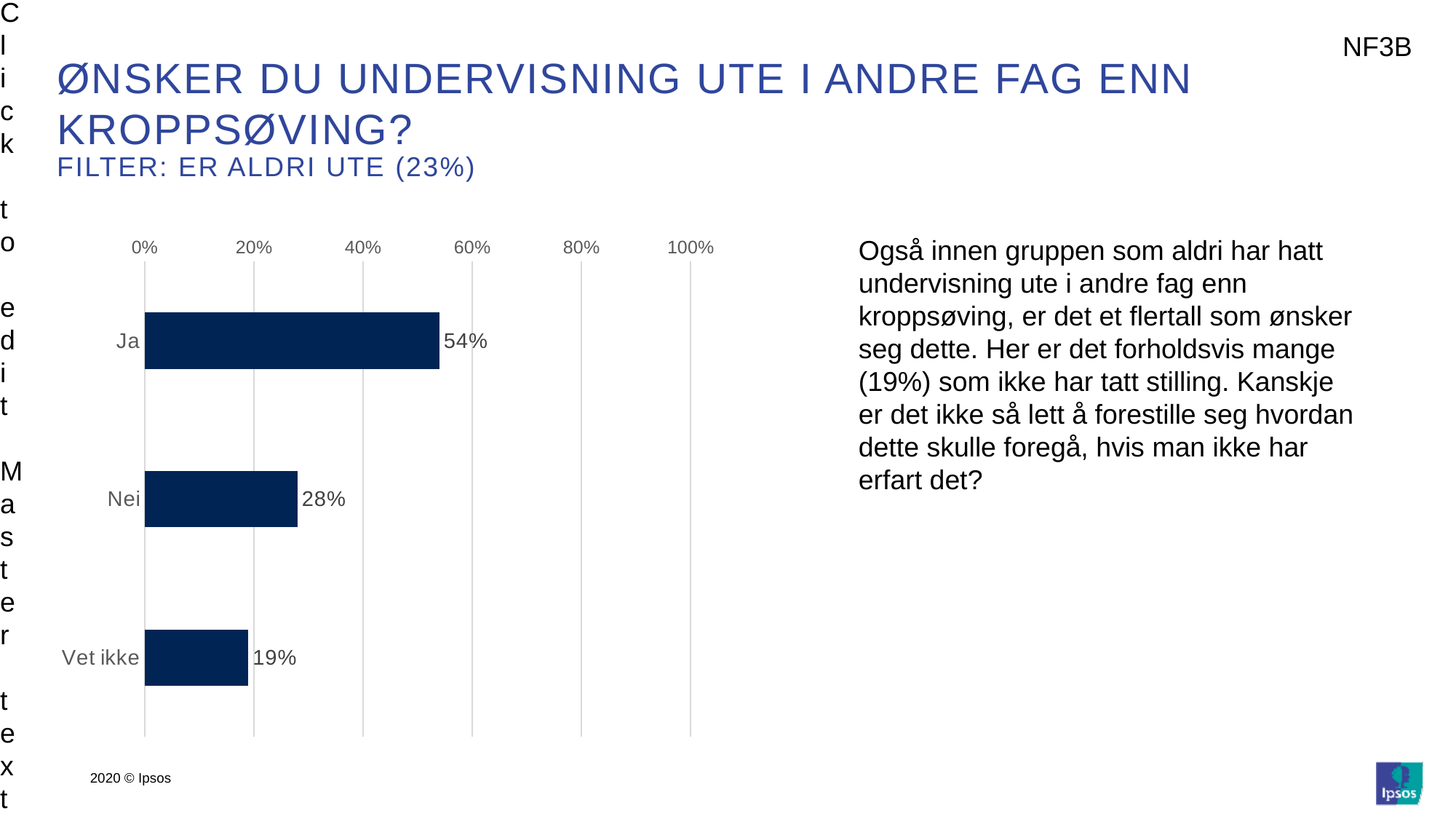
What is the difference between the values for Ja and Nei? 26% Is the value for Ja greater or less than 40%? greater How many categories are shown in the chart? 3 What kind of chart is shown on the slide? bar chart What is the value for Ja? 54% What is the highest tick value shown on the percentage axis? 100% Which category has the lowest value? Vet ikke What is the value for Vet ikke? 19% What is the value for Nei? 28% What is the difference between the values for Nei and Vet ikke? 9% Which category has the highest value? Ja Which is larger, the value for Nei or the value for Vet ikke? Nei